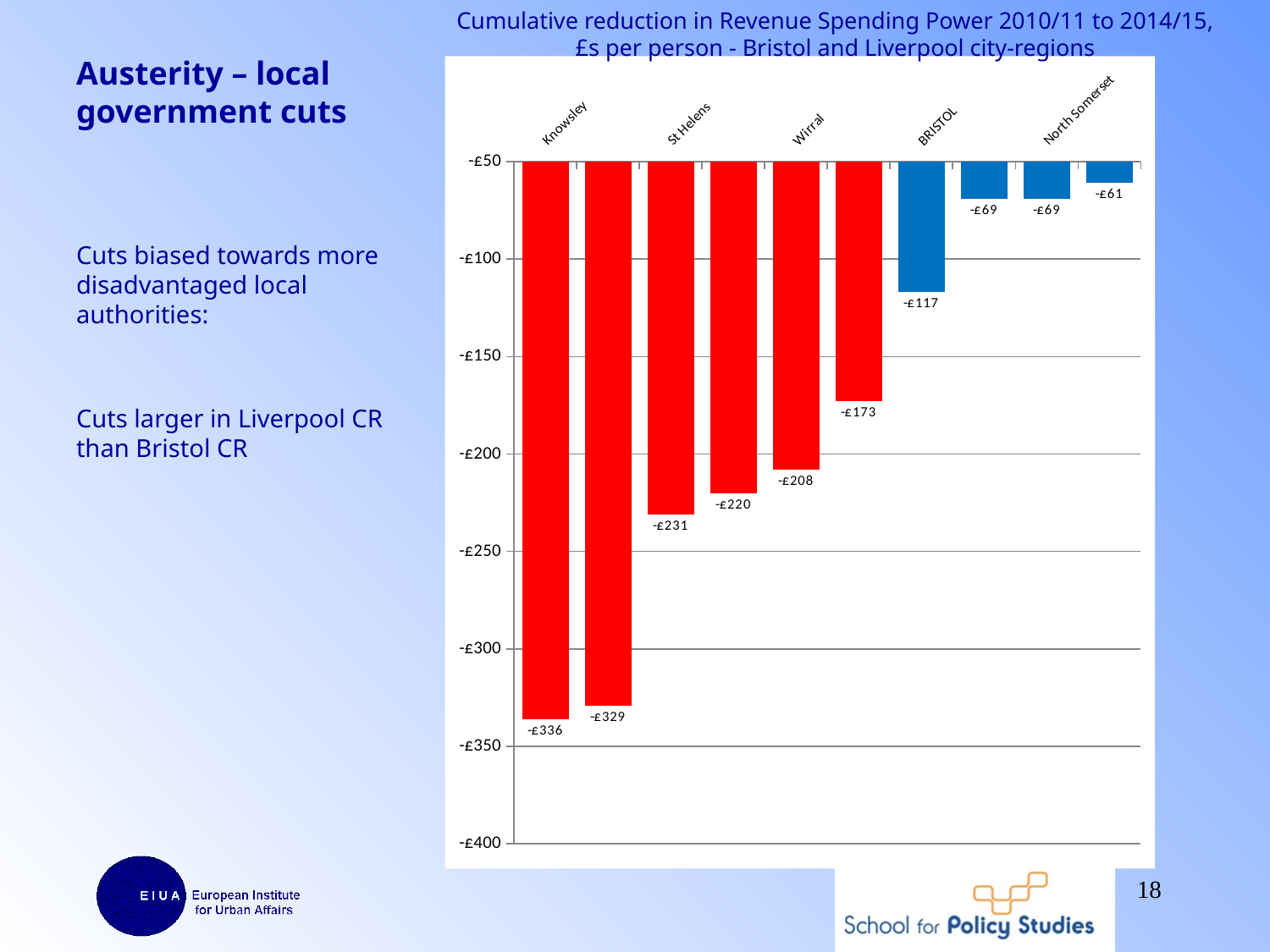
What type of chart is shown on the slide? Bar chart Which labelled local authority has the largest reduction in revenue spending power per person? Knowsley What value is shown for Wirral? -£208 What value is shown for North Somerset? -£69 How much larger is the reduction per person for Knowsley than for BRISTOL? £219 How many bars are plotted on the chart? 10 Which has the larger reduction per person, Wirral or BRISTOL? Wirral What value is shown for St Helens? -£231 What is the cumulative reduction in revenue spending power per person for Knowsley? -£336 What is the smallest reduction value shown on the chart? -£61 What value is shown for BRISTOL? -£117 Do the reductions get larger or smaller moving from left to right across the chart? Smaller